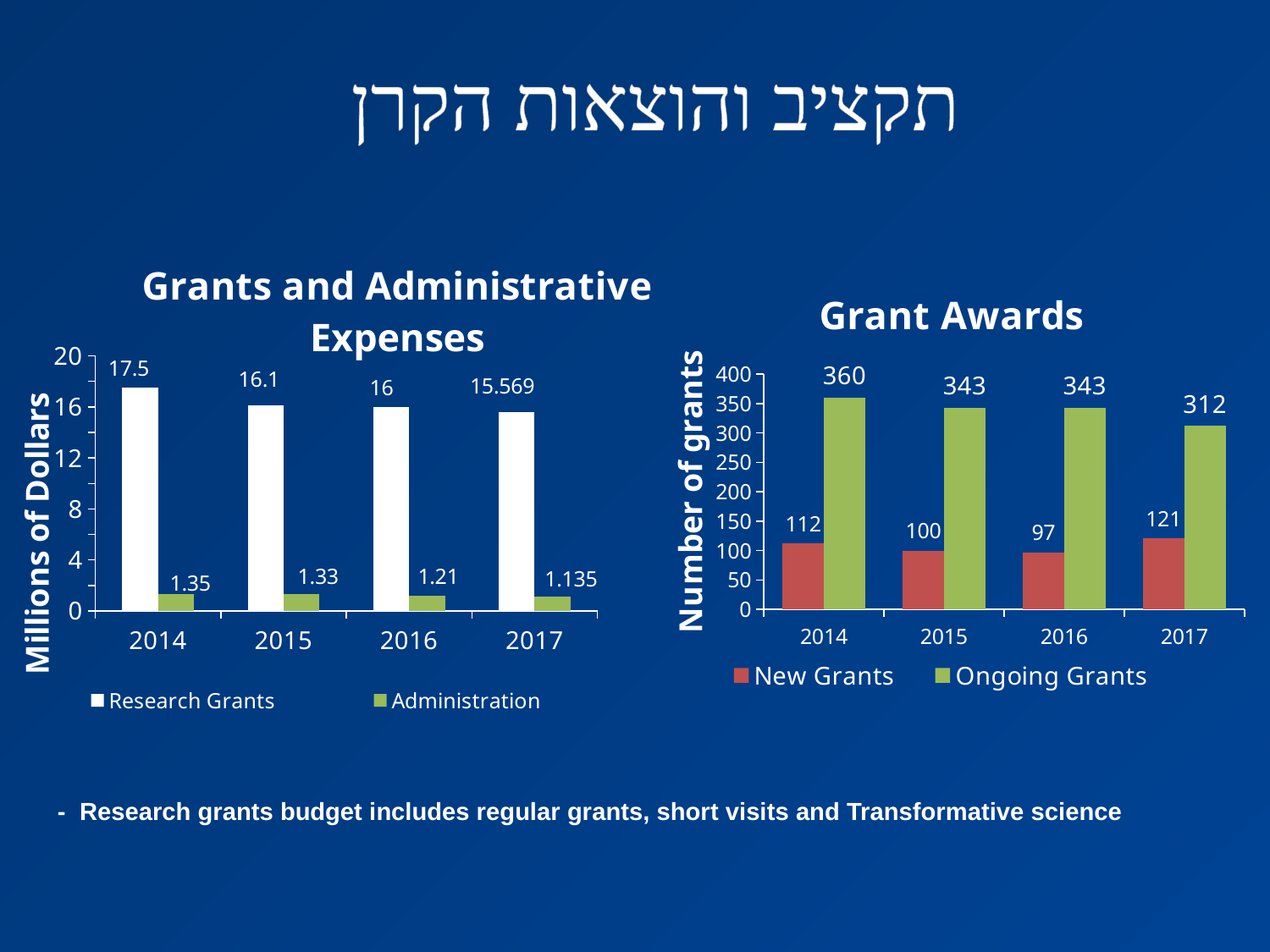
In the 'Grants and Administrative Expenses' chart, what is the difference between Research Grants in 2014 and 2015? 1.4 In the 'Grant Awards' chart, what is the difference between Ongoing Grants in 2014 and 2017? 48 In the 'Grants and Administrative Expenses' chart, what is the value for Administration in 2017? 1.135 In the 'Grants and Administrative Expenses' chart, which year has the lowest Research Grants value? 2017 In the 'Grant Awards' chart, what is the number of New Grants in 2016? 97 In the 'Grant Awards' chart, which year has the highest number of New Grants? 2017 In the 'Grants and Administrative Expenses' chart, what is the value for Research Grants in 2014? 17.5 What kind of chart is the 'Grant Awards' chart? bar chart In the 'Grants and Administrative Expenses' chart, how many series does the legend list? 2 In the 'Grant Awards' chart, which is larger: New Grants in 2015 or New Grants in 2017? New Grants in 2017 In the 'Grant Awards' chart, what is the number of Ongoing Grants in 2014? 360 In the 'Grants and Administrative Expenses' chart, do the Research Grants values rise or fall from 2014 to 2017? fall